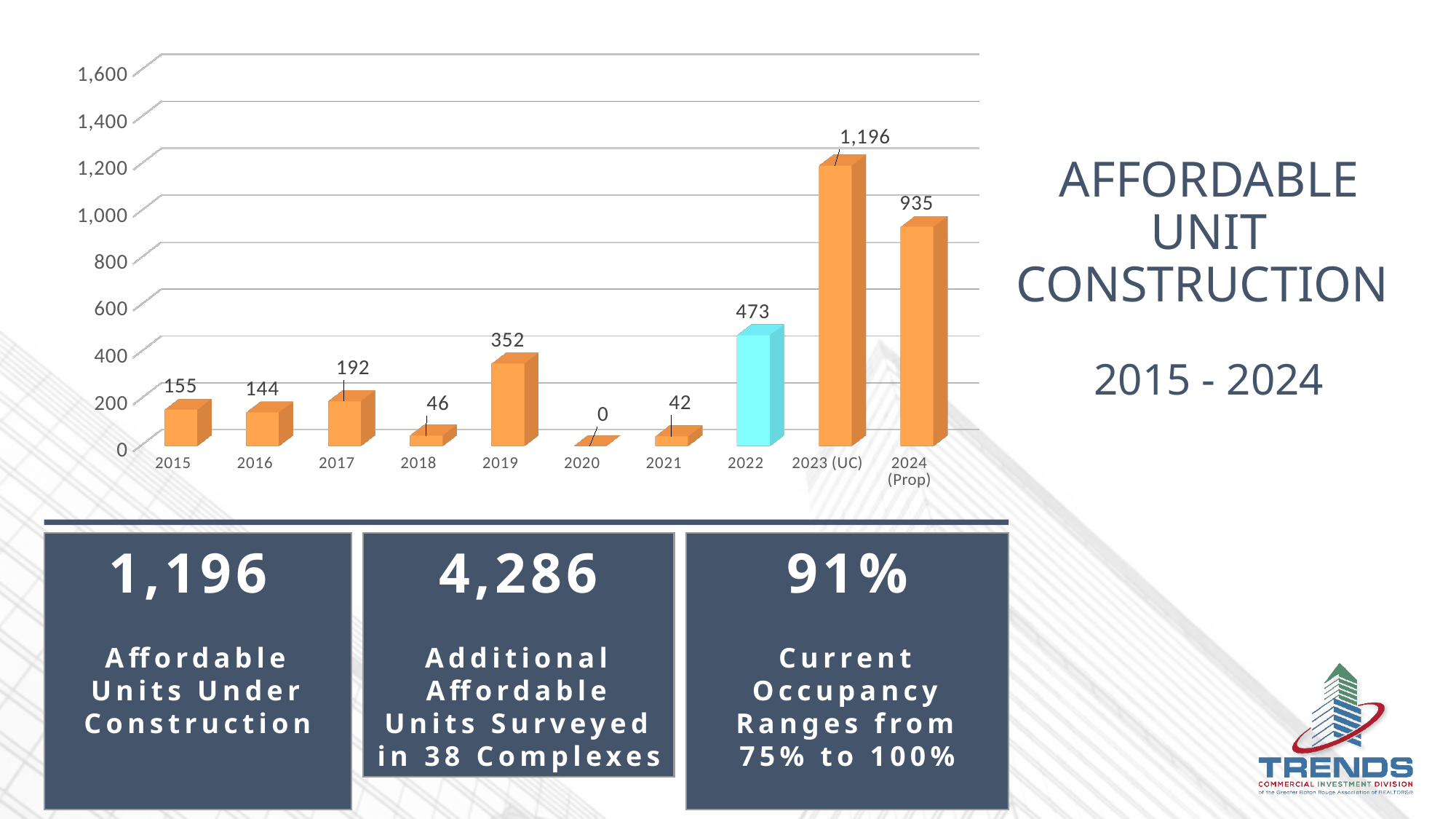
Do the values rise or fall from 2021 to 2023 (UC)? rise What is the value for 2019? 352 What is the value for 2022? 473 Which bar is coloured differently (blue) from the others? 2022 Which category has the highest value? 2023 (UC) Which is larger, the value for 2015 or the value for 2016? 2015 Is the value for 2022 greater or less than 400? greater How many categories are shown on the x axis? 10 What is the difference between the values for 2023 (UC) and 2024 (Prop)? 261 Which category has the lowest value? 2020 What is the value for 2024 (Prop)? 935 What kind of chart is shown? bar chart